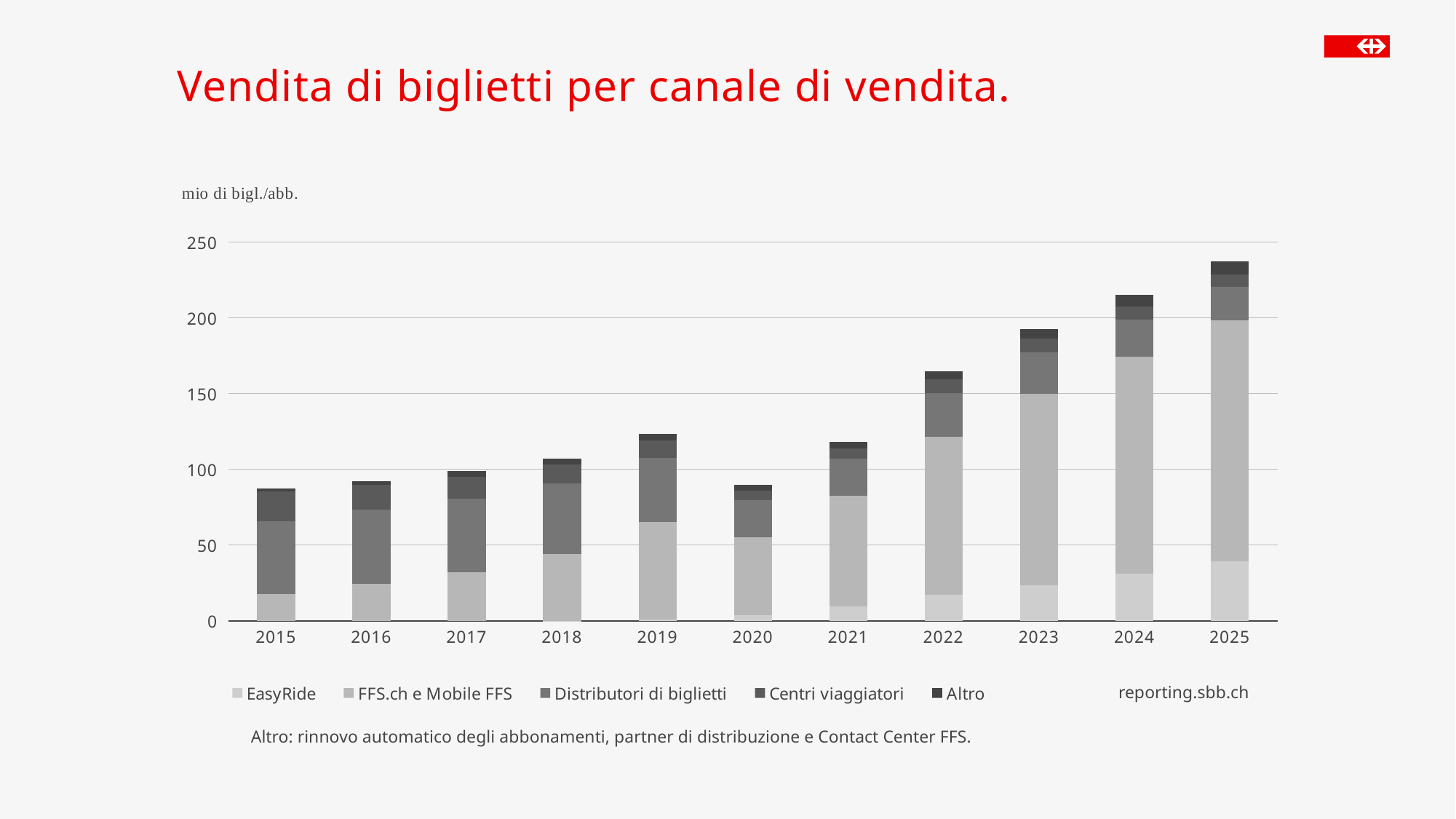
How many years are shown on the x axis of the chart? 11 Is the total for 2022 greater or less than 150? greater What is the title of the chart on the slide? Vendita di biglietti per canale di vendita. Is the total for 2025 greater or less than 200? greater Is the total for 2023 greater or less than 200? less How many series does the legend list? 5 Which year has the larger total bar, 2023 or 2024? 2024 Which year has the highest total bar? 2025 Which year has the larger total bar, 2019 or 2020? 2019 Do the total bars generally rise or fall from 2015 to 2025? rise What kind of chart is shown on the slide? stacked bar chart